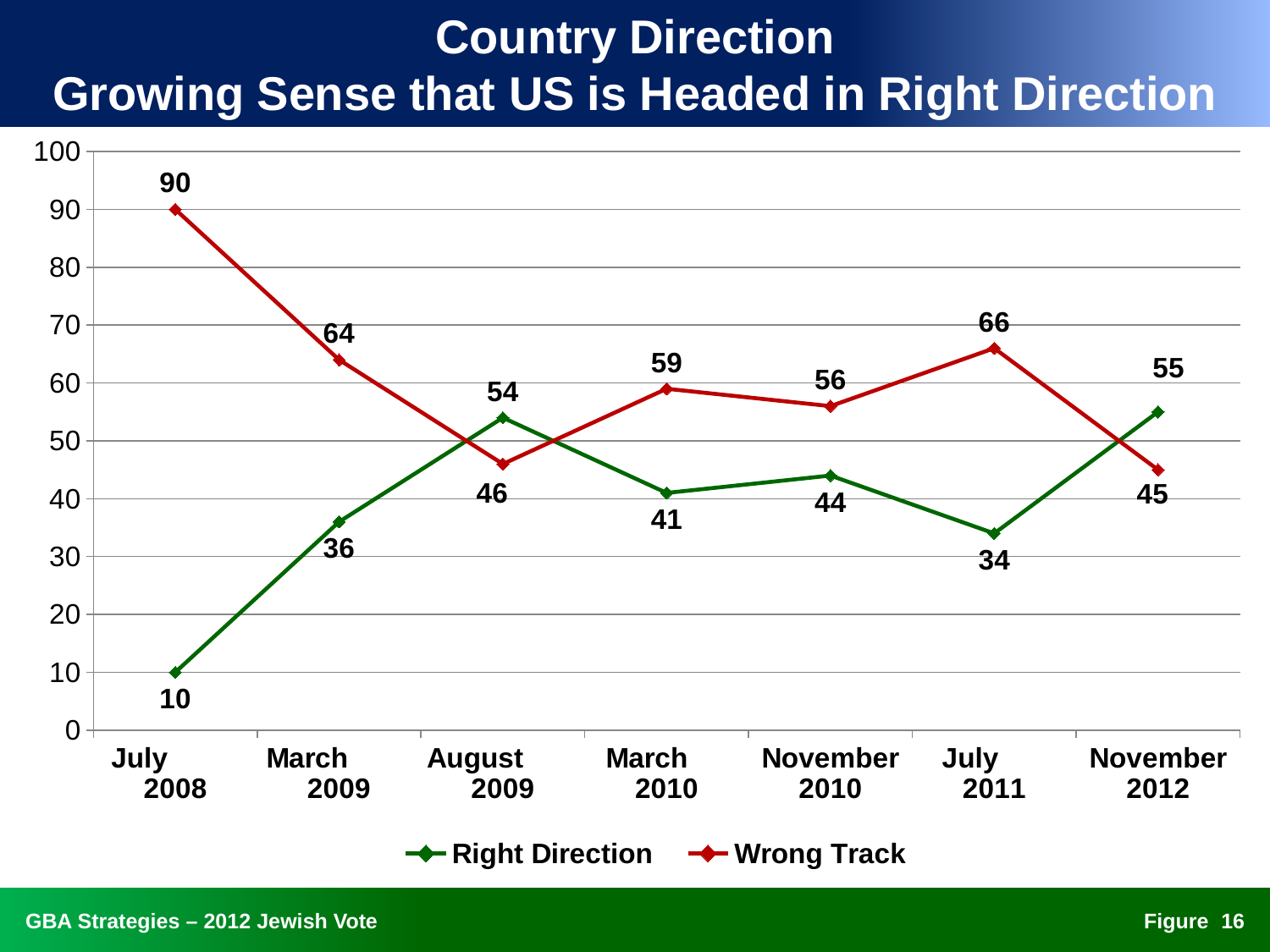
Does the Wrong Track value rise or fall from July 2008 to August 2009? Fall What is the Wrong Track value for July 2011? 66 Which is larger in August 2009, Right Direction or Wrong Track? Right Direction What is the difference between the Wrong Track and Right Direction values in July 2008? 80 What is the Right Direction value for November 2012? 55 How many series does the legend list? 2 What colour is the Right Direction line? Green How many dates are plotted on the x axis? 7 At which date is the Right Direction value lowest? July 2008 At which date is the Wrong Track value highest? July 2008 What is the Right Direction value for July 2008? 10 What kind of chart is shown on the slide? Line chart